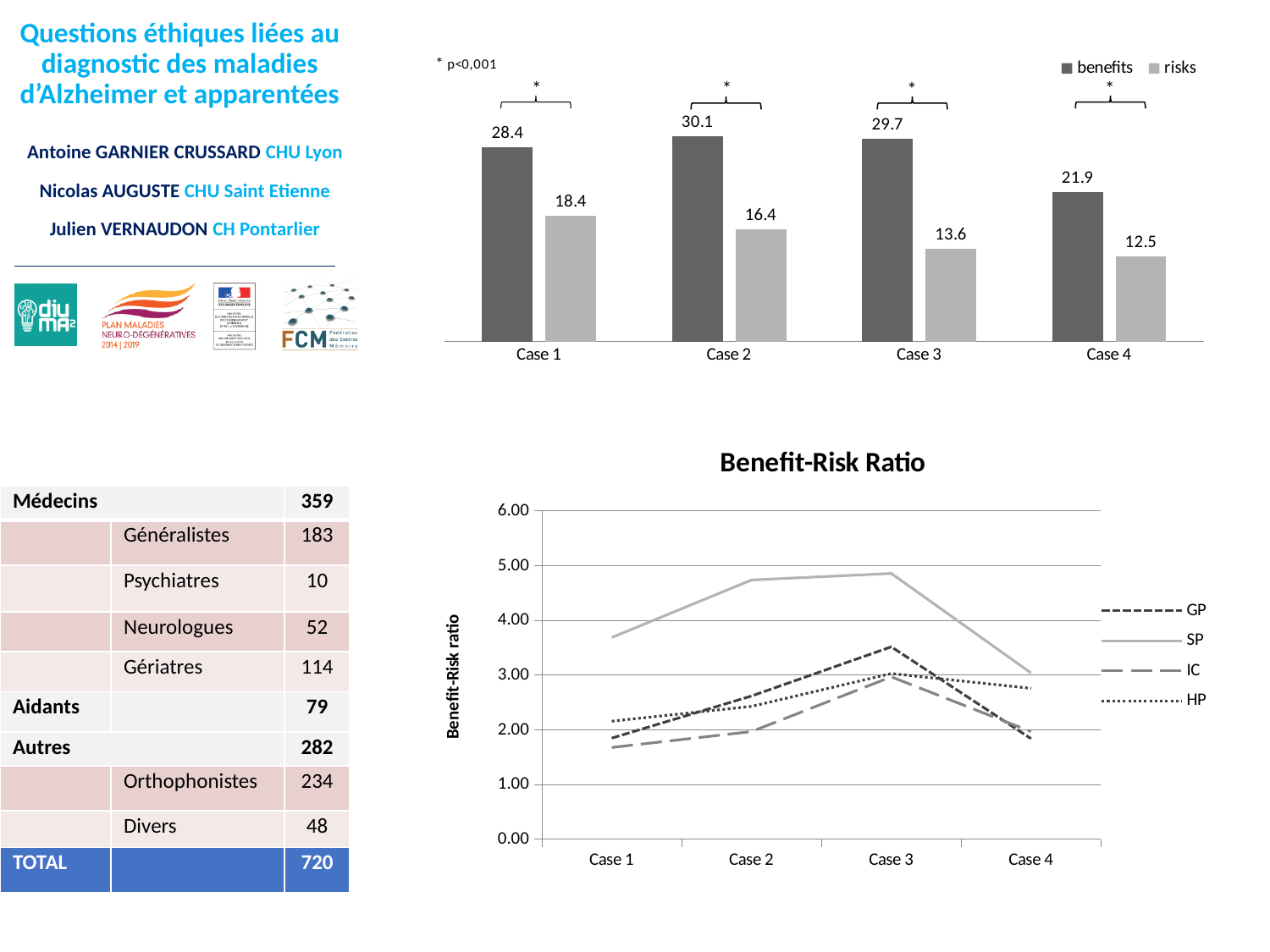
In the top bar chart, what is the difference between benefits and risks for Case 1? 10.0 In the top bar chart, which case has the highest benefits value? Case 2 In the top bar chart, what is the risks value for Case 4? 12.5 In the Benefit-Risk Ratio chart, which series has the highest value at Case 3? SP In the Benefit-Risk Ratio chart, does the SP series rise or fall from Case 3 to Case 4? fall What type of chart is the top chart showing benefits and risks? bar chart In the top bar chart, which case has the lowest risks value? Case 4 How many series does the legend of the top bar chart list? 2 In the Benefit-Risk Ratio chart, how many series does the legend list? 4 In the Benefit-Risk Ratio chart, is the value for SP at Case 2 greater or less than 4.00? greater In the top bar chart, what is the benefits value for Case 2? 30.1 In the top bar chart, which is larger for Case 3: benefits or risks? benefits